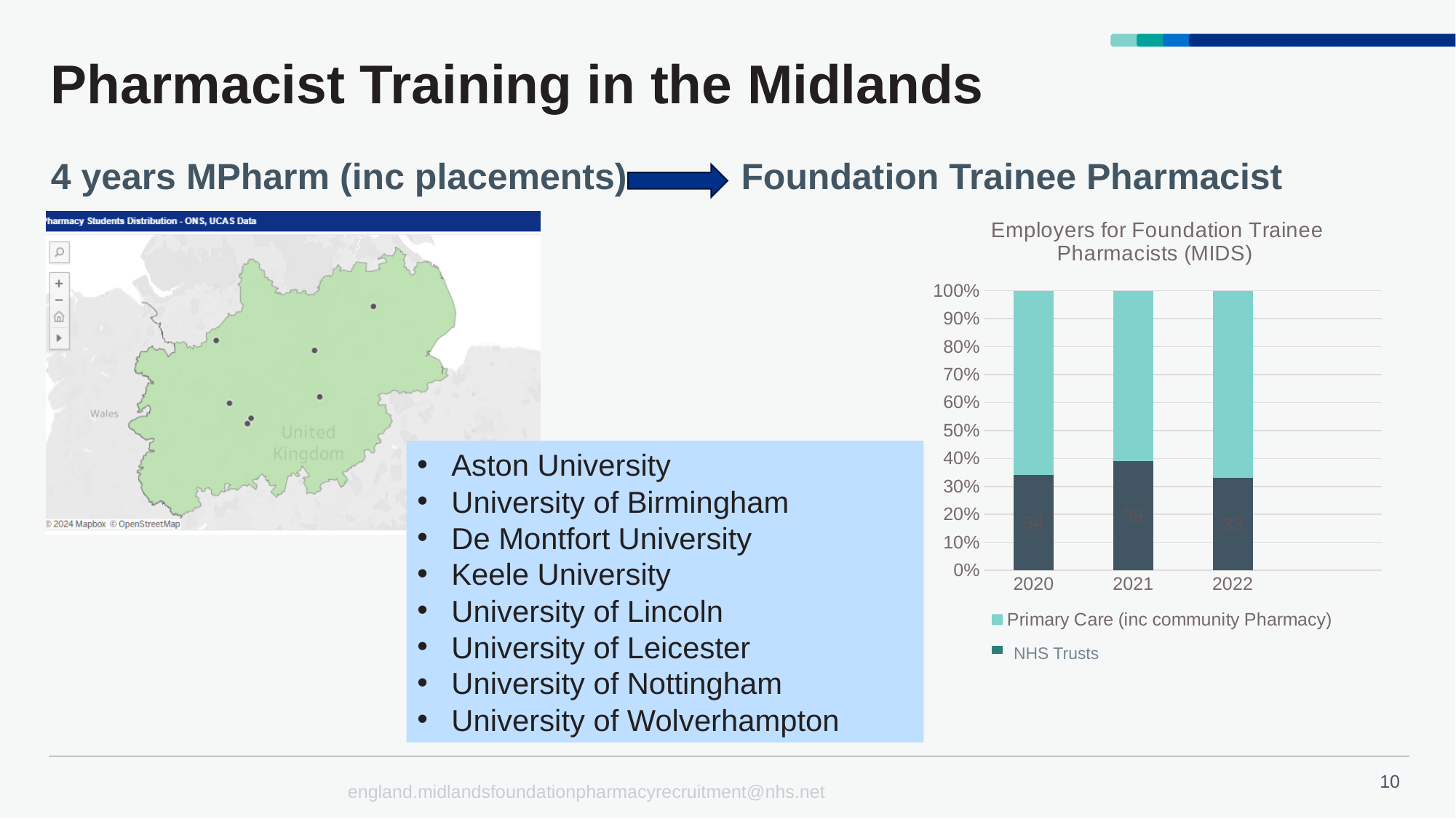
Is the NHS Trusts share for 2021 greater or less than 50% in the Employers for Foundation Trainee Pharmacists (MIDS) chart? less What is the value for NHS Trusts in 2022 in the Employers for Foundation Trainee Pharmacists (MIDS) chart? 33 In which year is the NHS Trusts value highest in the Employers for Foundation Trainee Pharmacists (MIDS) chart? 2021 What is the value for NHS Trusts in 2021 in the Employers for Foundation Trainee Pharmacists (MIDS) chart? 39 What kind of chart is the Employers for Foundation Trainee Pharmacists (MIDS) chart? Stacked bar chart How many series does the legend of the Employers for Foundation Trainee Pharmacists (MIDS) chart list? 2 Which year has the larger NHS Trusts value in the Employers for Foundation Trainee Pharmacists (MIDS) chart, 2020 or 2022? 2020 How many years are shown on the x axis of the Employers for Foundation Trainee Pharmacists (MIDS) chart? 3 What is the difference between the NHS Trusts values for 2021 and 2020 in the Employers for Foundation Trainee Pharmacists (MIDS) chart? 5 In which year is the NHS Trusts value lowest in the Employers for Foundation Trainee Pharmacists (MIDS) chart? 2022 What is the value for NHS Trusts in 2020 in the Employers for Foundation Trainee Pharmacists (MIDS) chart? 34 Is the Primary Care (inc community Pharmacy) share for 2020 greater or less than 50% in the Employers for Foundation Trainee Pharmacists (MIDS) chart? greater